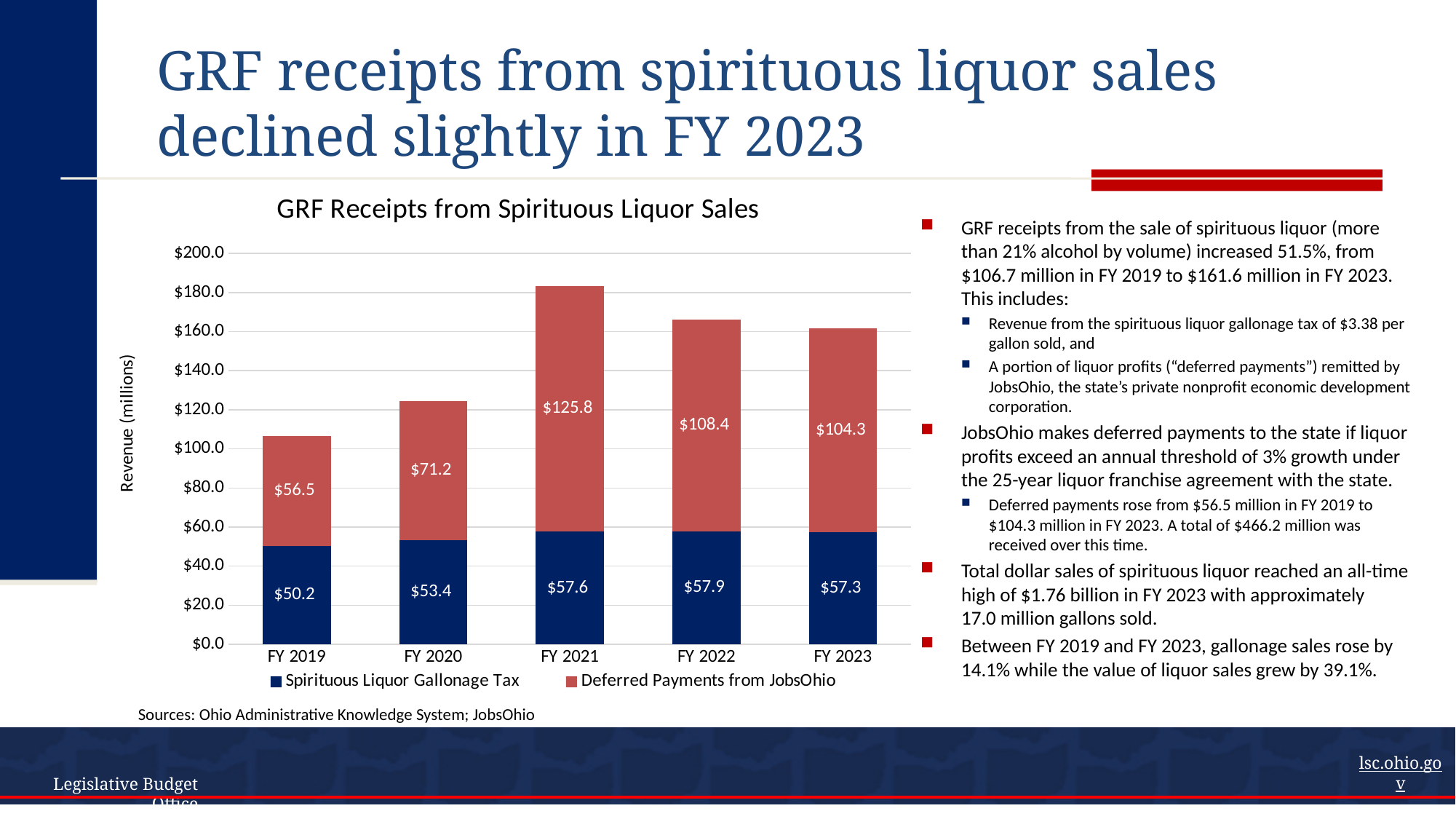
What is the title of the chart? GRF Receipts from Spirituous Liquor Sales Is the total stacked bar for FY 2021 greater or less than $180.0? greater Which is larger: Spirituous Liquor Gallonage Tax in FY 2020 or in FY 2021? FY 2021 What is the total of the stacked bar for FY 2019? $106.7 How many fiscal years are shown on the x axis? 5 Which fiscal year has the lowest Spirituous Liquor Gallonage Tax? FY 2019 What is the value of Deferred Payments from JobsOhio for FY 2021? $125.8 Which fiscal year has the highest Deferred Payments from JobsOhio? FY 2021 What is the difference between Deferred Payments from JobsOhio in FY 2022 and FY 2023? $4.1 What kind of chart is shown on the slide? Stacked bar chart What is the value of Spirituous Liquor Gallonage Tax for FY 2019? $50.2 How many series does the legend list? 2